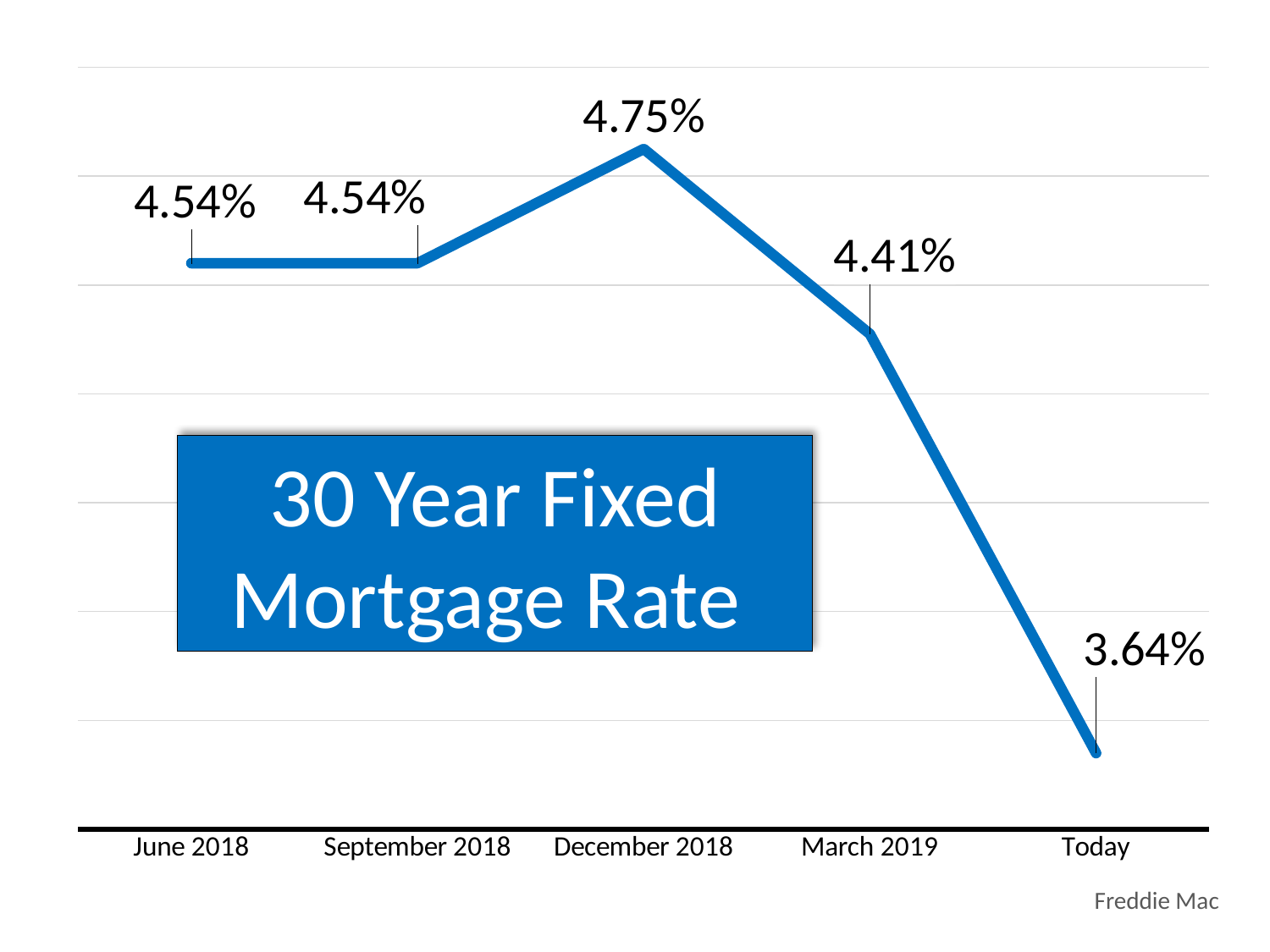
Which point on the chart has the highest mortgage rate? December 2018 What kind of chart is shown on the slide? Line chart What is the 30 Year Fixed Mortgage Rate for Today? 3.64% What is the source cited for the chart data? Freddie Mac Which point on the chart has the lowest mortgage rate? Today What is the 30 Year Fixed Mortgage Rate for December 2018? 4.75% What is the 30 Year Fixed Mortgage Rate for March 2019? 4.41% How many data points are plotted on the chart? 5 What is the difference between the March 2019 rate and the Today rate? 0.77% What is the 30 Year Fixed Mortgage Rate for June 2018? 4.54% What is the difference between the December 2018 rate and the Today rate? 1.11% Which is larger, the rate for March 2019 or the rate for Today? March 2019